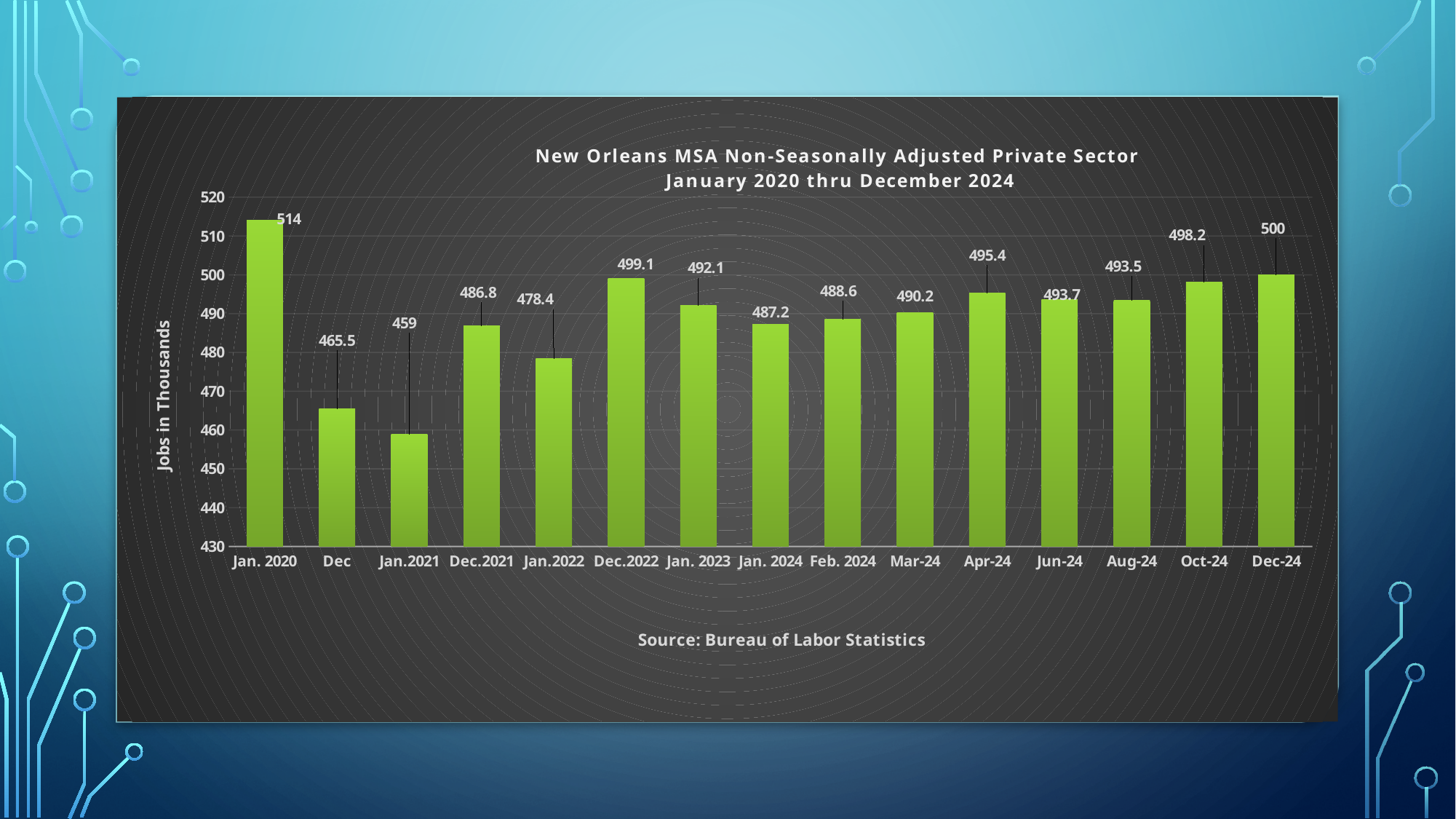
What is the value for Apr-24? 495.4 What is the value for Jan.2021? 459 What is the value for Jan. 2020? 514 Which category has the highest value? Jan. 2020 What is the difference between the values for Dec.2022 and Jan.2022? 20.7 What is the value for Dec-24? 500 Which category has the lowest value? Jan.2021 What kind of chart is shown on the slide? Bar chart How many bars are plotted in the chart? 15 Which is larger, the value for Oct-24 or the value for Aug-24? Oct-24 What is the label of the vertical axis? Jobs in Thousands What is the difference between the values for Jan. 2020 and Dec-24? 14